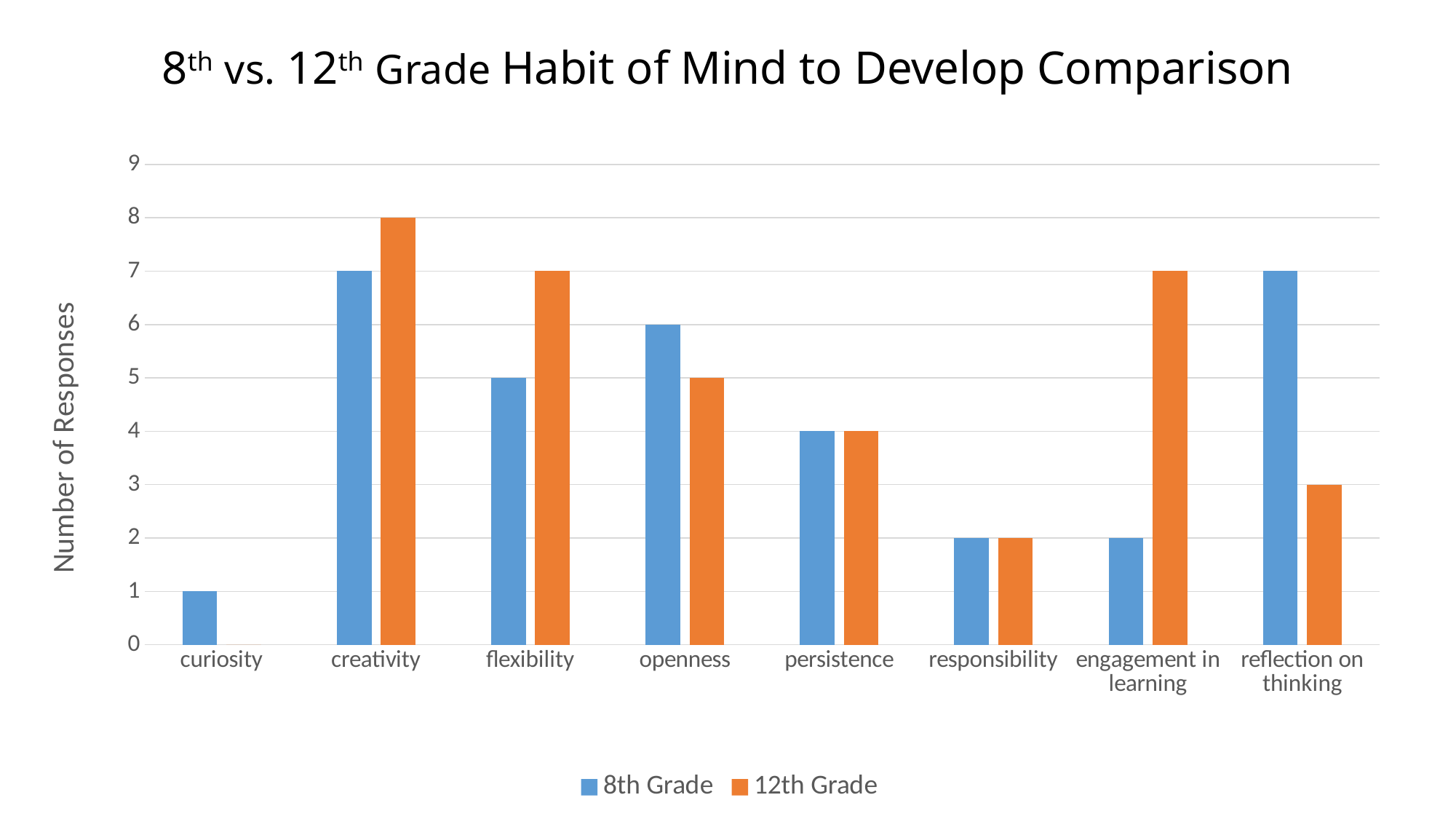
What type of chart is shown on the slide? bar chart What is the difference between the 12th Grade and 8th Grade values for engagement in learning? 5 How many series does the legend list? 2 What is the number of responses for reflection on thinking in the 8th Grade series? 7 Is the 8th Grade value for flexibility greater or less than 6? less What is the number of responses for creativity in the 12th Grade series? 8 Which category has the highest value in the 12th Grade series? creativity What is the number of responses for engagement in learning in the 12th Grade series? 7 How many habit-of-mind categories are shown on the x axis? 8 For openness, which series has the larger value, 8th Grade or 12th Grade? 8th Grade Which category has the lowest value in the 8th Grade series? curiosity What is the label on the vertical axis? Number of Responses